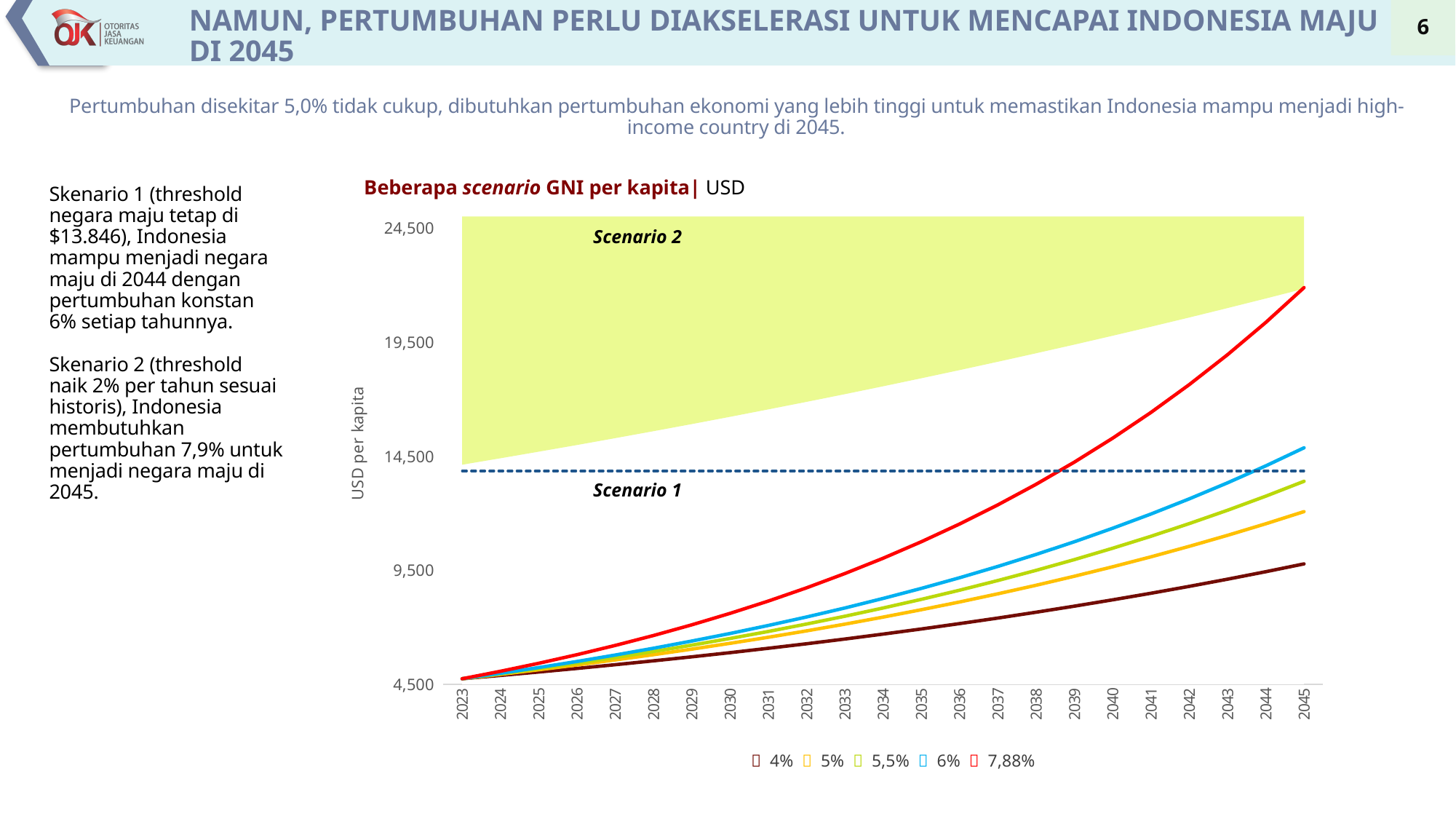
How many series does the legend list? 5 What kind of chart is shown on the slide? line chart Do the series values rise or fall from 2023 to 2045? rise Is the value of the 5% series in 2045 greater or less than 14,500? less Which growth-rate series reaches the highest GNI per capita in 2045? 7,88% Is the value of the 4% series in 2045 greater or less than 14,500? less How many years are shown on the x axis? 23 What is the label of the y axis? USD per kapita In 2045, which is larger: the 6% series or the 5% series? 6% Which growth-rate series has the lowest GNI per capita in 2045? 4% What is the first year shown on the x axis? 2023 Is the value of the 7,88% series in 2045 greater or less than 19,500? greater